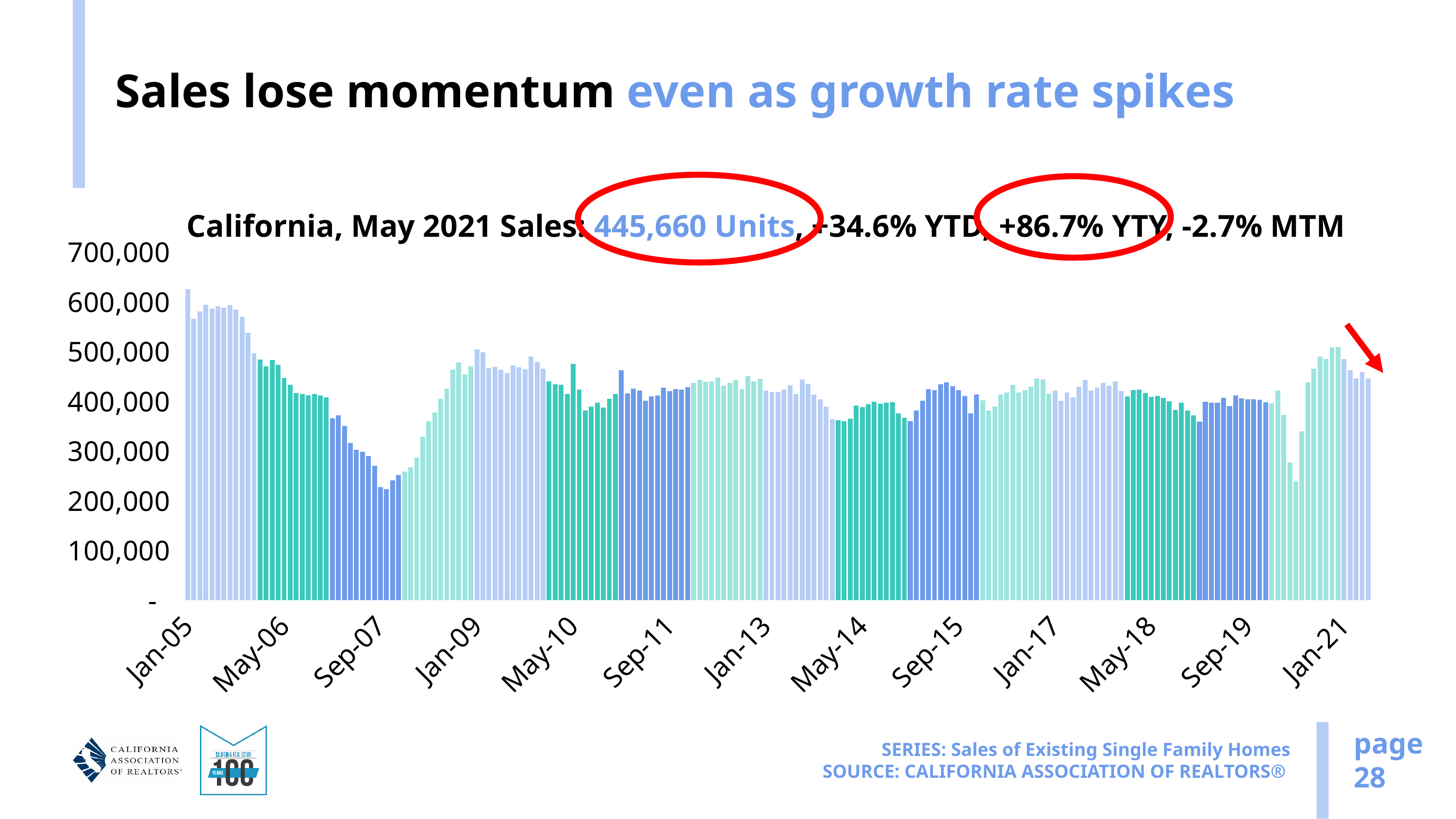
Is the value for Jan-21 greater or less than 400,000? greater What kind of chart is shown on the slide? bar chart What is the month-to-month (MTM) change in sales stated in the chart title? -2.7% Which month has the highest sales value on the chart? Jan-05 What is the year-to-date (YTD) change in sales stated in the chart title? +34.6% What is the highest value labelled on the vertical axis? 700,000 According to the chart title, how many units were sold in California in May 2021? 445,660 Units Is the value for Jan-05 greater or less than 600,000? greater Over the last few months shown on the chart (after the early-2021 peak), do sales rise or fall? fall Is the lowest bar on the chart greater or less than 300,000? less What is the year-to-year (YTY) change in sales stated in the chart title? +86.7% Do sales rise or fall between Jan-05 and Sep-07? fall